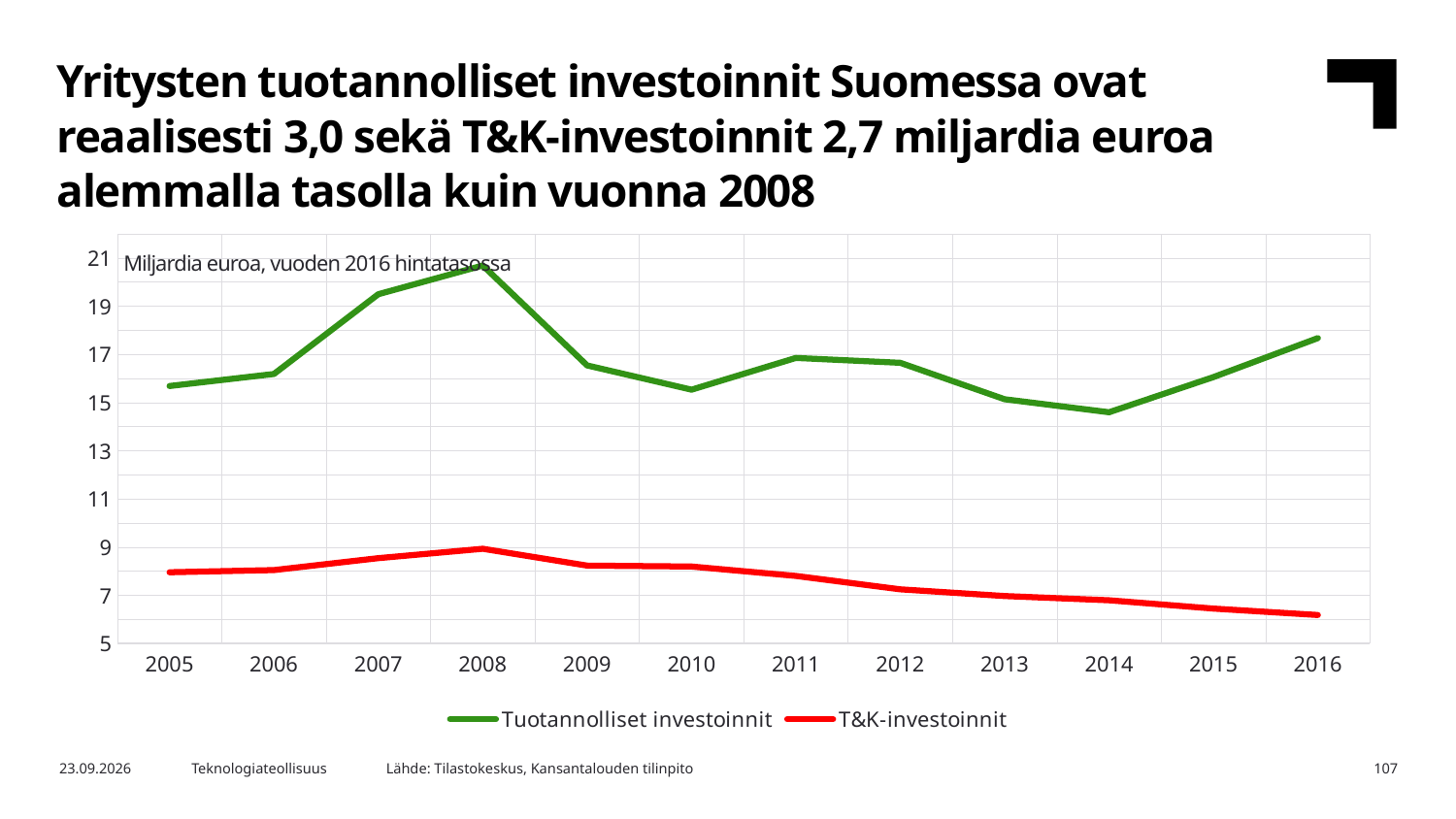
Does T&K-investoinnit rise or fall from 2008 to 2016? fall In which year is T&K-investoinnit at its lowest? 2016 Which series has the larger value in 2010, Tuotannolliset investoinnit or T&K-investoinnit? Tuotannolliset investoinnit What kind of chart is shown on the slide? line chart How many series does the legend list? 2 What unit label is shown inside the chart area? Miljardia euroa, vuoden 2016 hintatasossa In which year is Tuotannolliset investoinnit at its lowest? 2014 How many years are plotted along the x axis? 12 In which year is Tuotannolliset investoinnit at its highest? 2008 Is the value for Tuotannolliset investoinnit in 2008 greater or less than 19? greater Is the value for T&K-investoinnit in 2016 greater or less than 7? less In which year is T&K-investoinnit at its highest? 2008